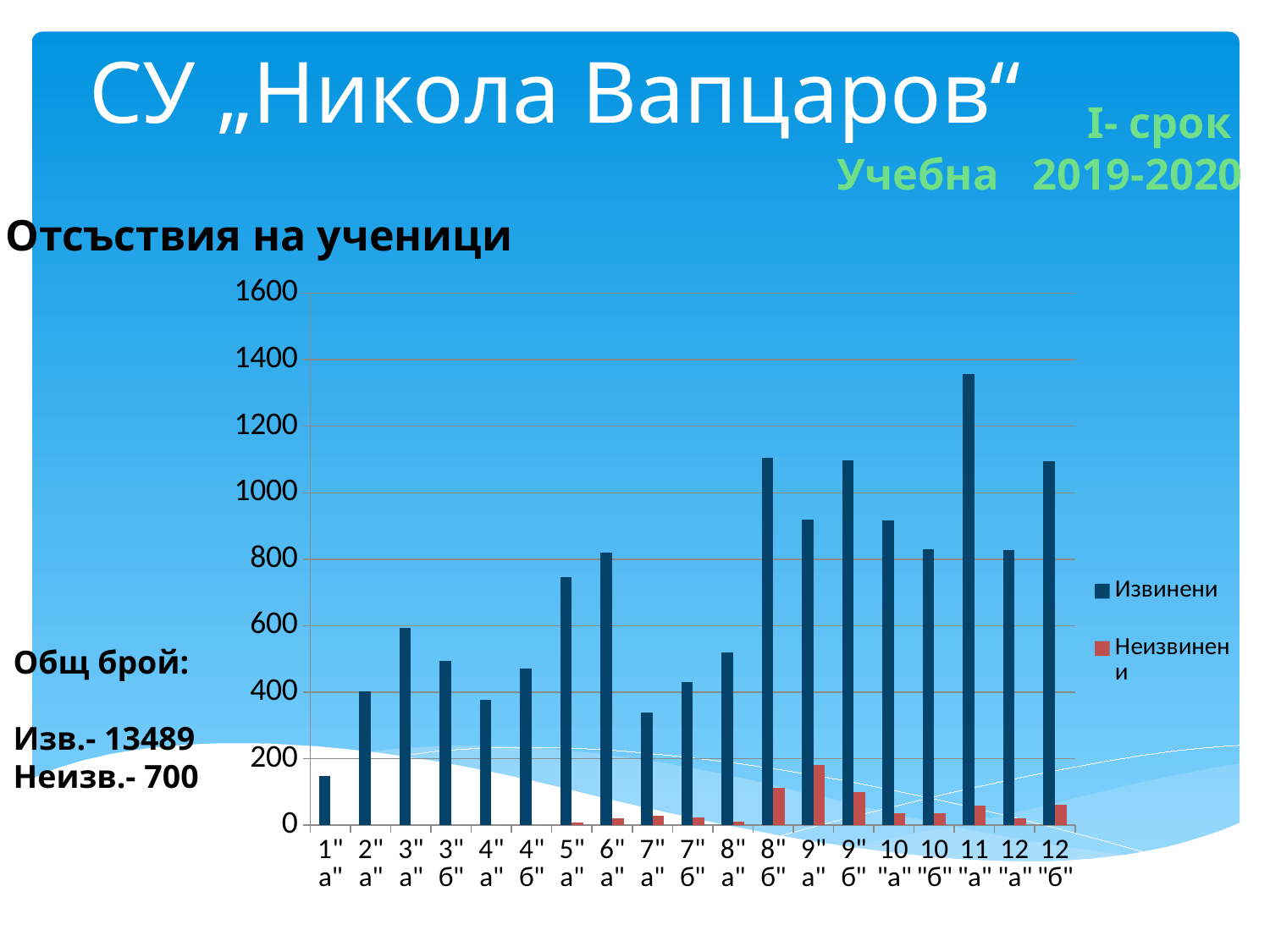
Which class has the highest value for Извинени? 11"а" Is the Извинени value for 7"а" greater or less than 400? less How many classes (categories) are shown on the x axis? 19 What kind of chart is shown on the slide? bar chart Which class has the highest value for Неизвинени? 9"а" Is the Извинени value for 11"а" greater or less than 1200? greater Which class has the lowest value for Извинени? 1"а" Is the Извинени value for 8"б" greater or less than 1000? greater How many series does the legend list? 2 Which has the larger Извинени value, 8"б" or 9"а"? 8"б" What are the two series named in the legend? Извинени and Неизвинени